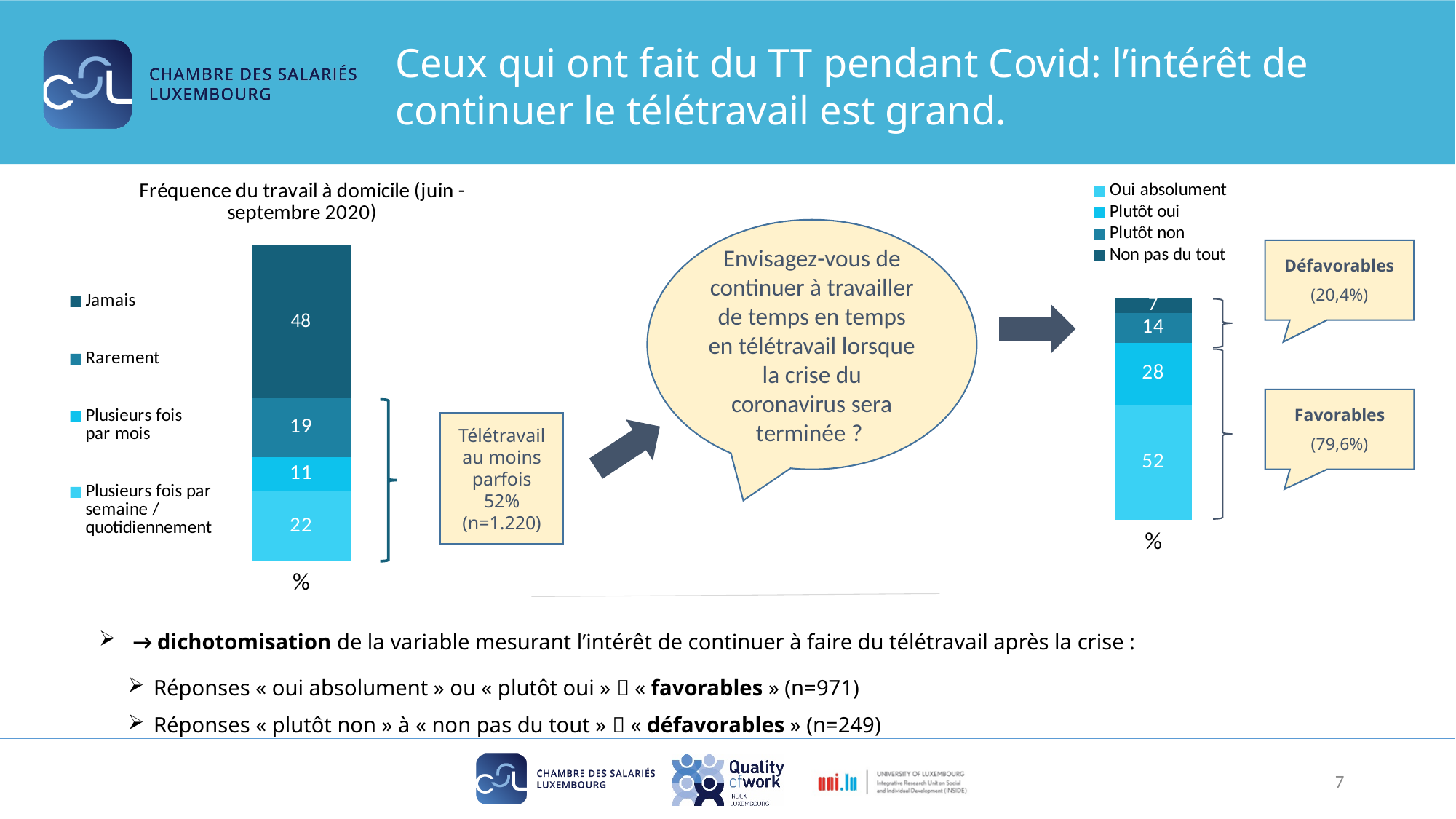
In the chart titled 'Fréquence du travail à domicile (juin - septembre 2020)', which category has the lowest value? Plusieurs fois par mois In the chart on the right of the slide, what is the value for 'Non pas du tout'? 7 In the chart on the right of the slide, how many entries does the legend list? 4 In the chart titled 'Fréquence du travail à domicile (juin - septembre 2020)', what is the difference between the values for 'Jamais' and 'Rarement'? 29 In the chart on the right of the slide, what is the value for 'Oui absolument'? 52 In the chart titled 'Fréquence du travail à domicile (juin - septembre 2020)', what is the value for 'Plusieurs fois par mois'? 11 What kind of chart is the chart titled 'Fréquence du travail à domicile (juin - septembre 2020)'? Stacked bar chart In the chart on the right of the slide, which is larger, 'Plutôt oui' or 'Plutôt non'? Plutôt oui In the chart titled 'Fréquence du travail à domicile (juin - septembre 2020)', what is the value for 'Jamais'? 48 In the chart titled 'Fréquence du travail à domicile (juin - septembre 2020)', which category has the highest value? Jamais In the chart on the right of the slide, what is the total of 'Oui absolument' and 'Plutôt oui'? 80 In the chart titled 'Fréquence du travail à domicile (juin - septembre 2020)', how many categories does the legend list? 4